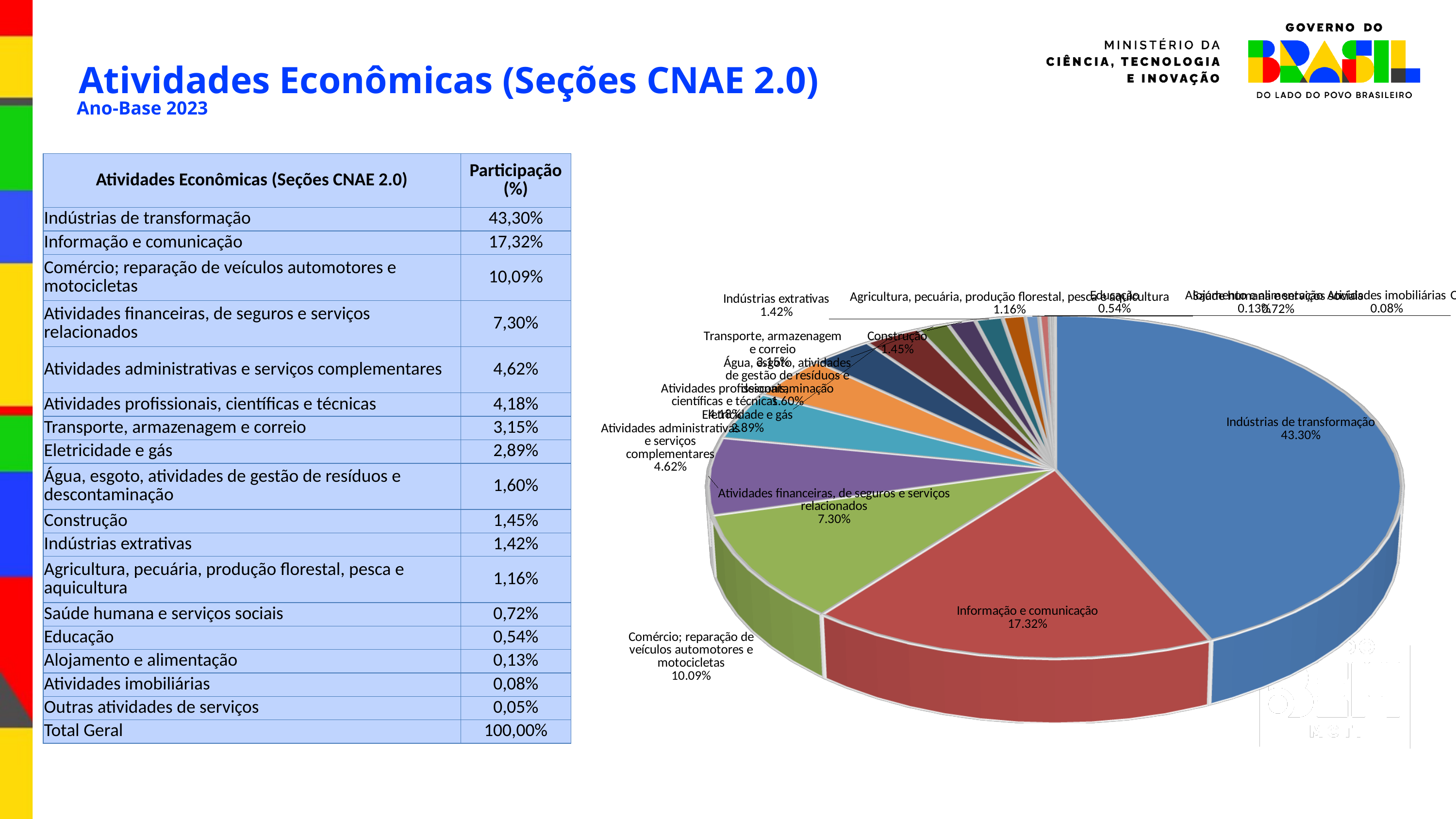
What is the combined share of Informação e comunicação and Comércio; reparação de veículos automotores e motocicletas in the pie chart? 27.41% What is the share shown for Indústrias de transformação in the pie chart? 43.30% What is the share shown for Atividades financeiras, de seguros e serviços relacionados in the pie chart? 7.30% What is the difference between the shares of Indústrias de transformação and Informação e comunicação in the pie chart? 25.98% What is the share shown for Eletricidade e gás in the pie chart? 2.89% What is the share shown for Comércio; reparação de veículos automotores e motocicletas in the pie chart? 10.09% Which category has the largest slice in the pie chart? Indústrias de transformação What is the share shown for Informação e comunicação in the pie chart? 17.32% What kind of chart is shown on the slide? pie chart What is the share shown for Educação in the pie chart? 0.54% What is the share shown for Indústrias extrativas in the pie chart? 1.42% Which slice is larger in the pie chart: Atividades administrativas e serviços complementares or Construção? Atividades administrativas e serviços complementares